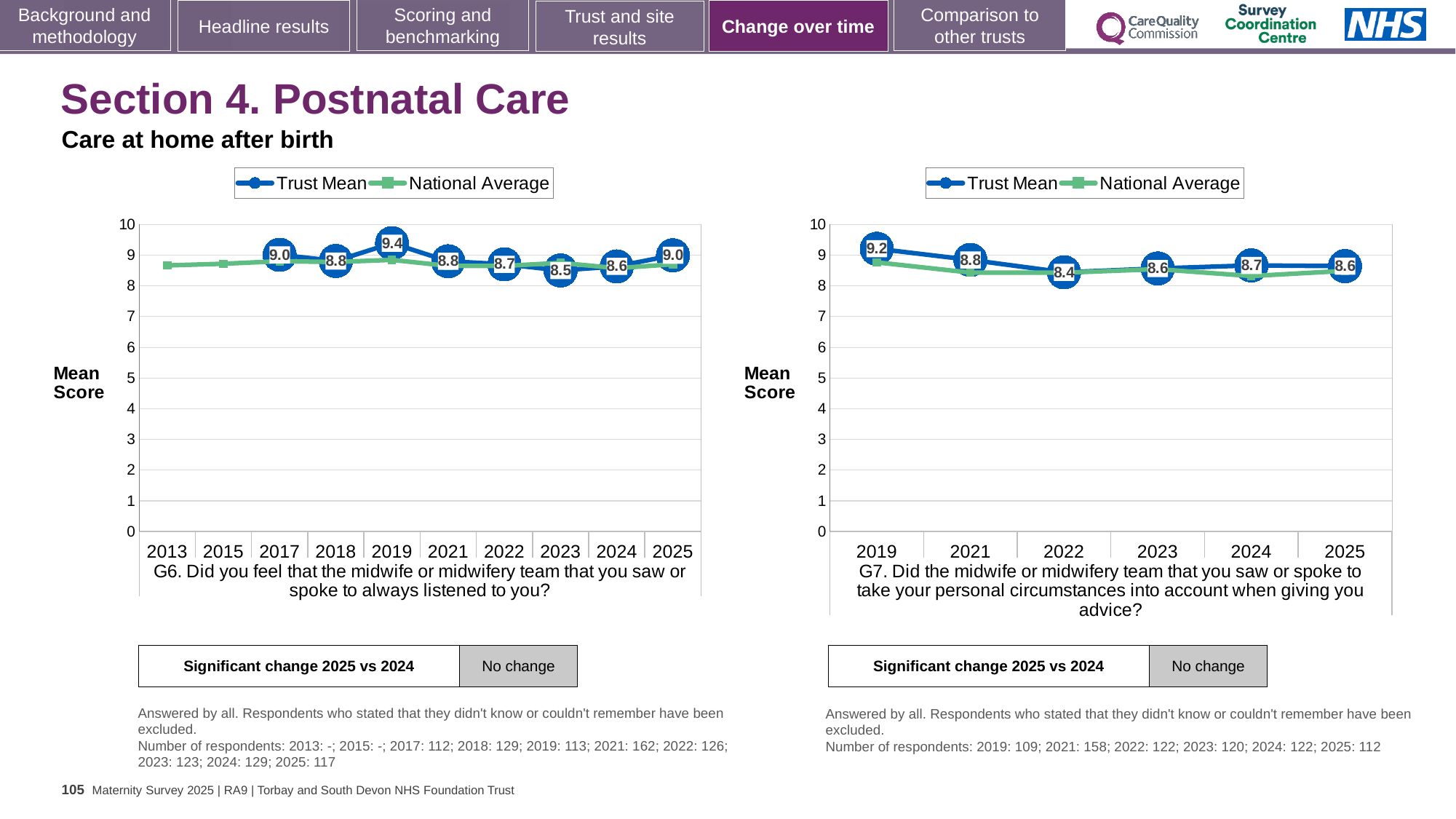
In the left chart (G6), what is the Trust Mean for 2025? 9.0 In the right chart (G7), is the Trust Mean higher in 2019 or in 2025? 2019 In the right chart (G7), what is the Trust Mean for 2019? 9.2 In the right chart (G7), which year has the lowest Trust Mean? 2022 In the left chart (G6), what is the Trust Mean for 2019? 9.4 What type of chart is the left chart (G6)? Line chart How many years are shown on the x axis of the right chart (G7)? 6 In the left chart (G6), which year has the highest Trust Mean? 2019 In the right chart (G7), what is the Trust Mean for 2022? 8.4 In the left chart (G6), which year has the lowest labelled Trust Mean? 2023 How many series does the legend of the left chart (G6) list? 2 In the left chart (G6), what is the difference between the Trust Mean in 2019 and in 2023? 0.9